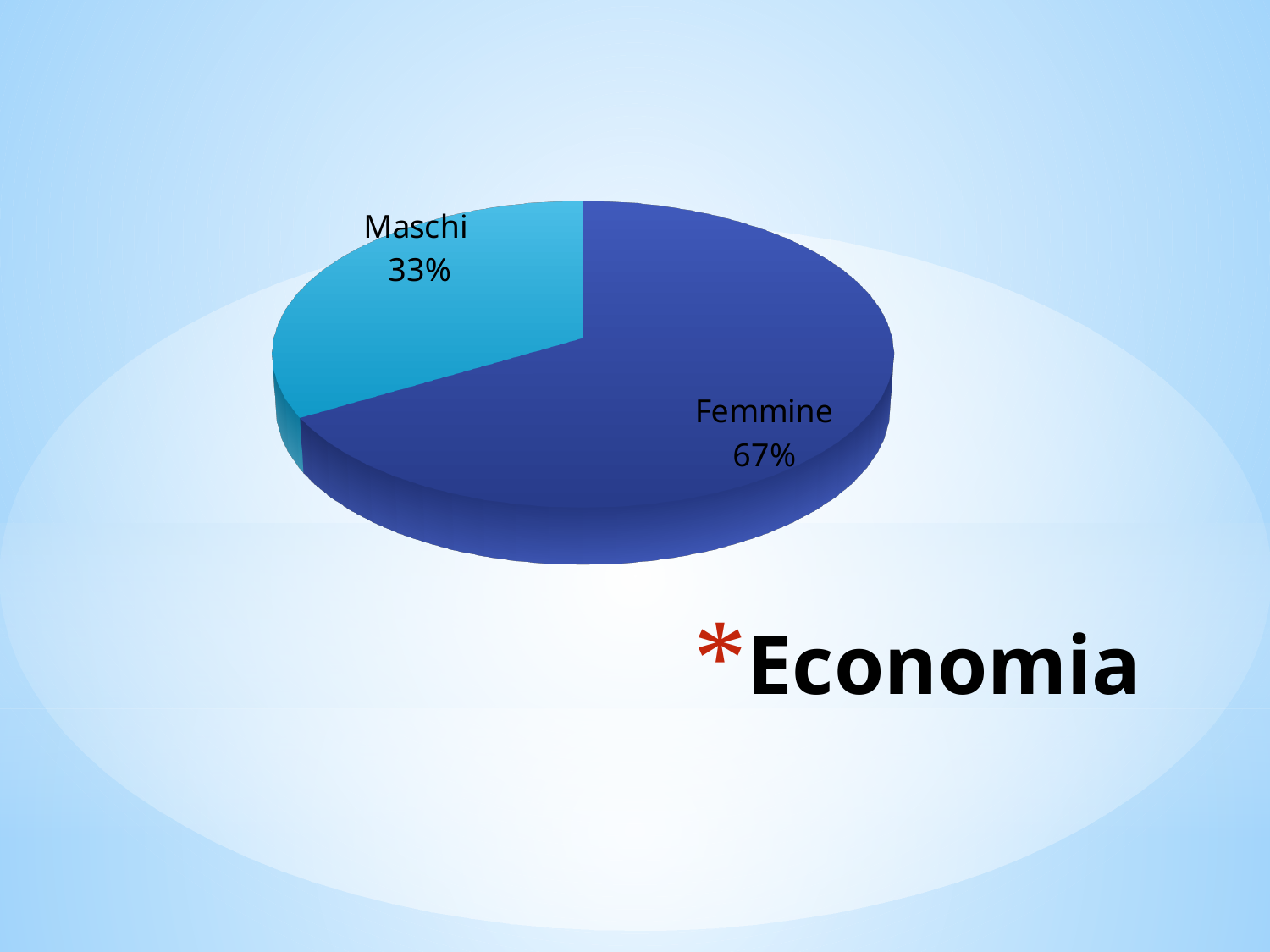
What kind of chart is shown on the slide? Pie chart What is the difference in percentage points between Femmine and Maschi? 34 Which slice is the largest? Femmine What colour is the Maschi slice? Light blue Which is larger, Maschi or Femmine? Femmine What text appears below the chart on the slide? Economia What share of the pie does Maschi have? 33% What share of the pie does Femmine have? 67% Which slice is the smallest? Maschi How many slices does the pie chart have? 2